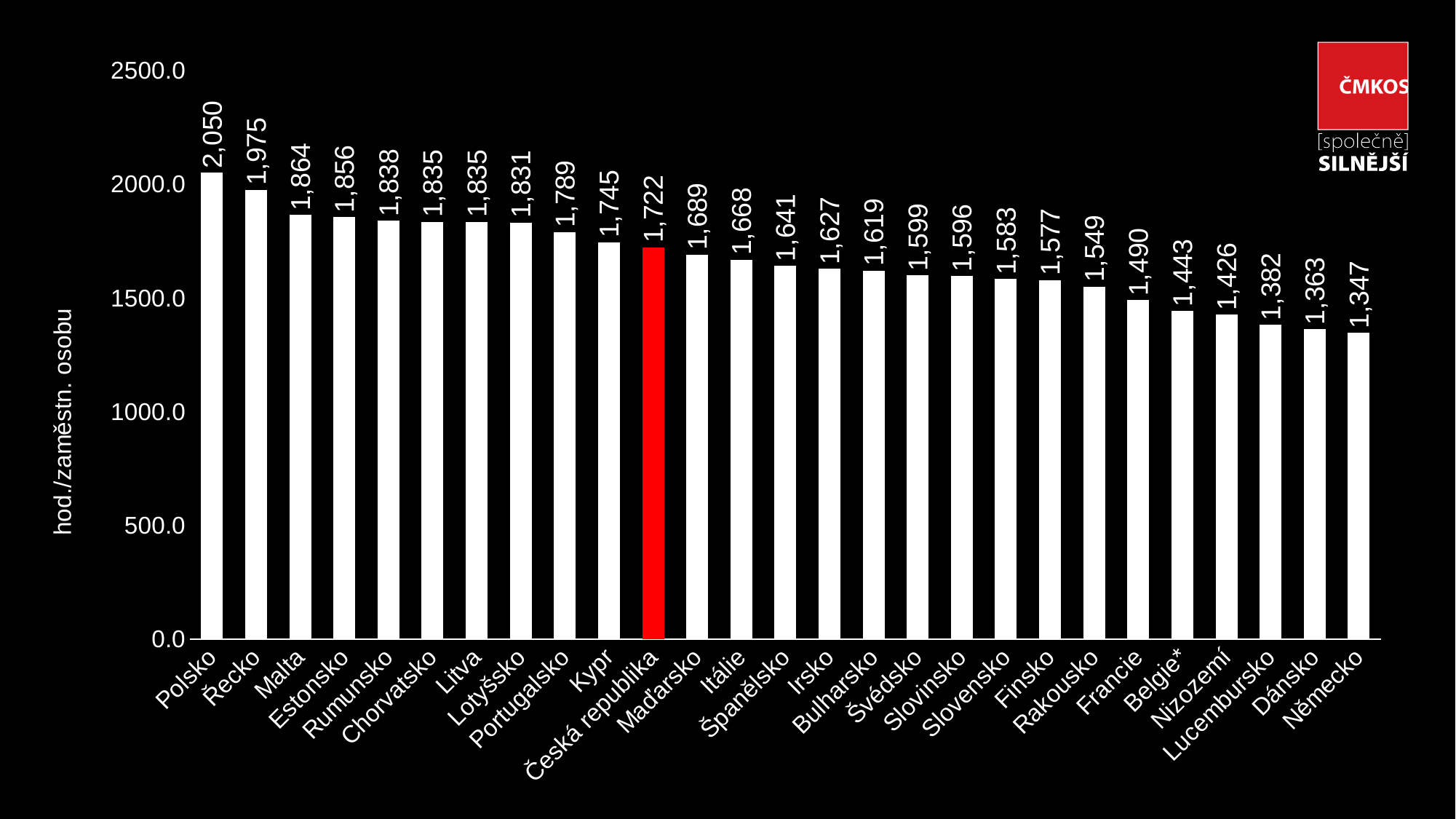
How many countries are shown on the chart? 27 What kind of chart is shown on the slide? bar chart What is the value for Česká republika? 1,722 Which bar is highlighted in red? Česká republika Which country has the lowest value? Německo Which has a larger value, Řecko or Malta? Řecko What is the value for Polsko? 2,050 Which country has the highest value? Polsko Is the value for Francie greater or less than 1500.0? less What is the difference between the values for Polsko and Německo? 703 What is the difference between the values for Česká republika and Slovensko? 139 What is the value for Slovensko? 1,583